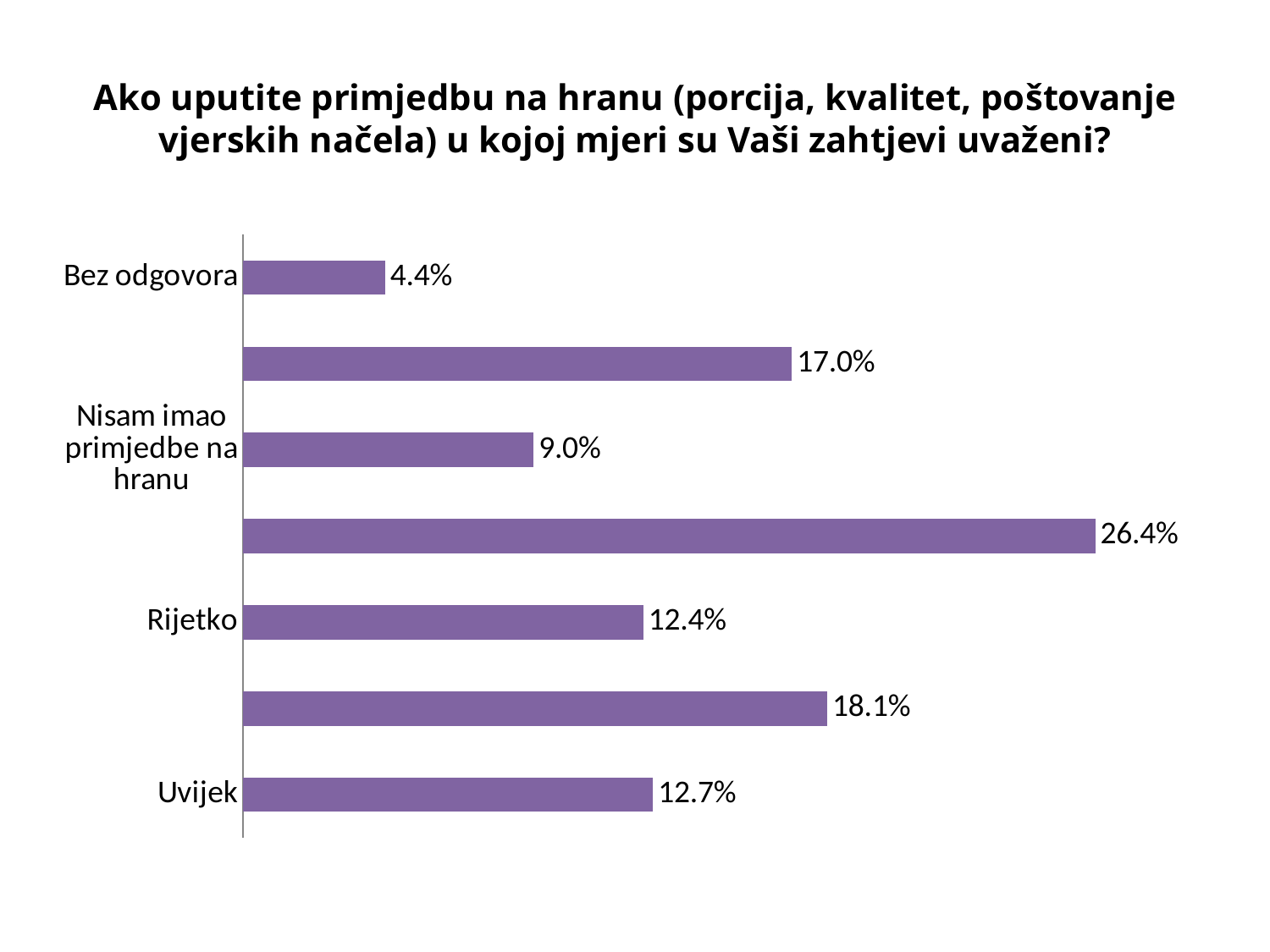
Which is larger, the value for Nisam imao primjedbe na hranu or the value for Bez odgovora? Nisam imao primjedbe na hranu What is the highest value shown on the chart? 26.4% What is the difference between the values for Rijetko and Bez odgovora? 8.0% What is the value for Rijetko? 12.4% What is the value for Nisam imao primjedbe na hranu? 9.0% What kind of chart is shown on the slide? Bar chart What is the difference between the values for Uvijek and Rijetko? 0.3% Which category has the lowest value? Bez odgovora How many bars are plotted on the chart? 7 Which is larger, the value for Uvijek or the value for Rijetko? Uvijek What is the value for Uvijek? 12.7% What is the value for Bez odgovora? 4.4%